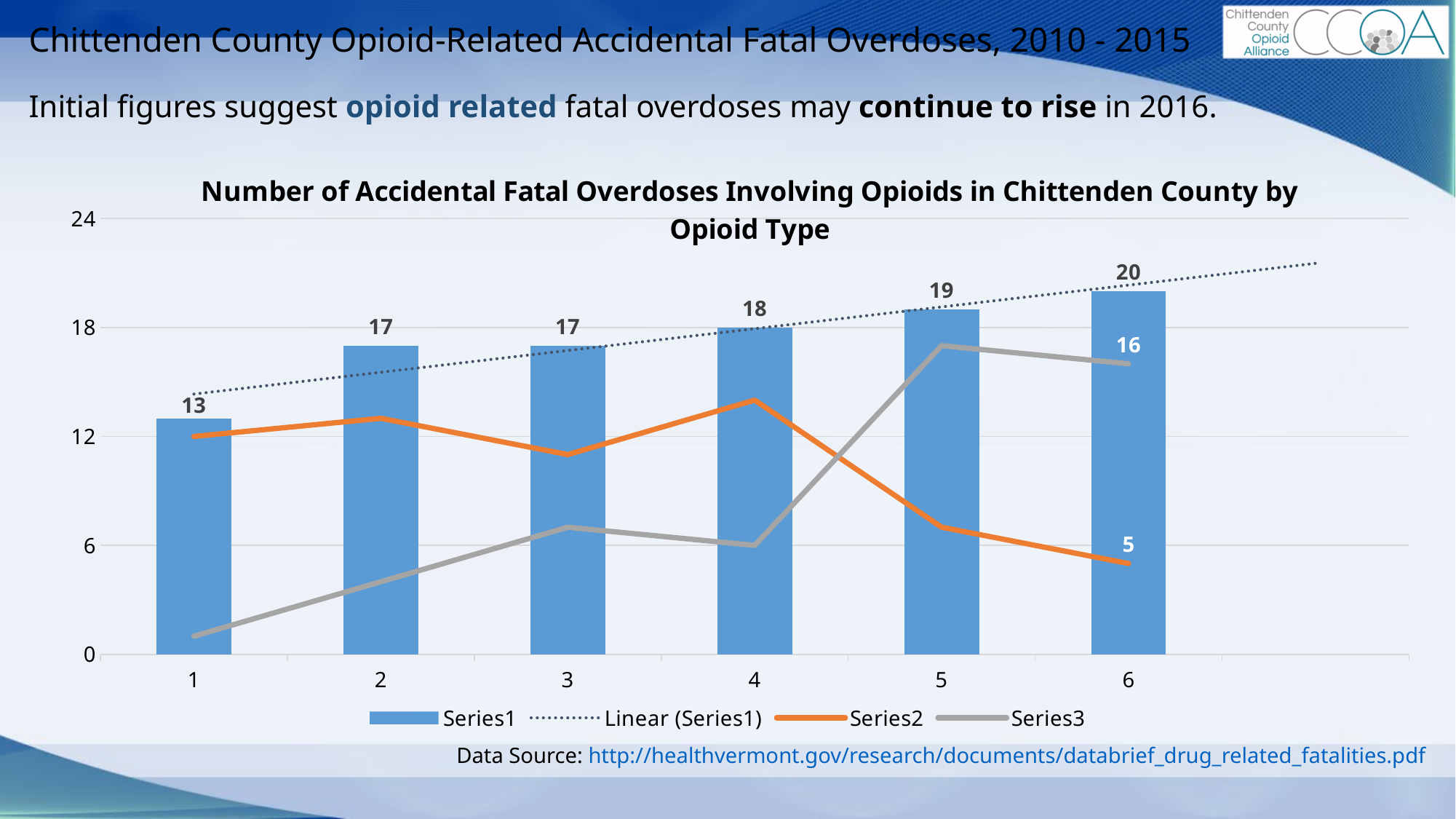
What is the difference between the Series1 values for category 6 and category 1? 7 What is the value of Series3 at category 6? 16 Which category has the lowest Series1 value? 1 What is the value of Series2 at category 6? 5 How many categories are shown on the x axis? 6 What is the value of Series1 for category 1? 13 Is the Series2 value at category 1 greater or less than 6? greater Which category has the highest Series1 value? 6 What is the value of Series1 for category 6? 20 Which is larger at category 6: Series2 or Series3? Series3 How many entries does the legend list? 4 Do the Series1 bar values generally rise or fall from category 1 to category 6? rise